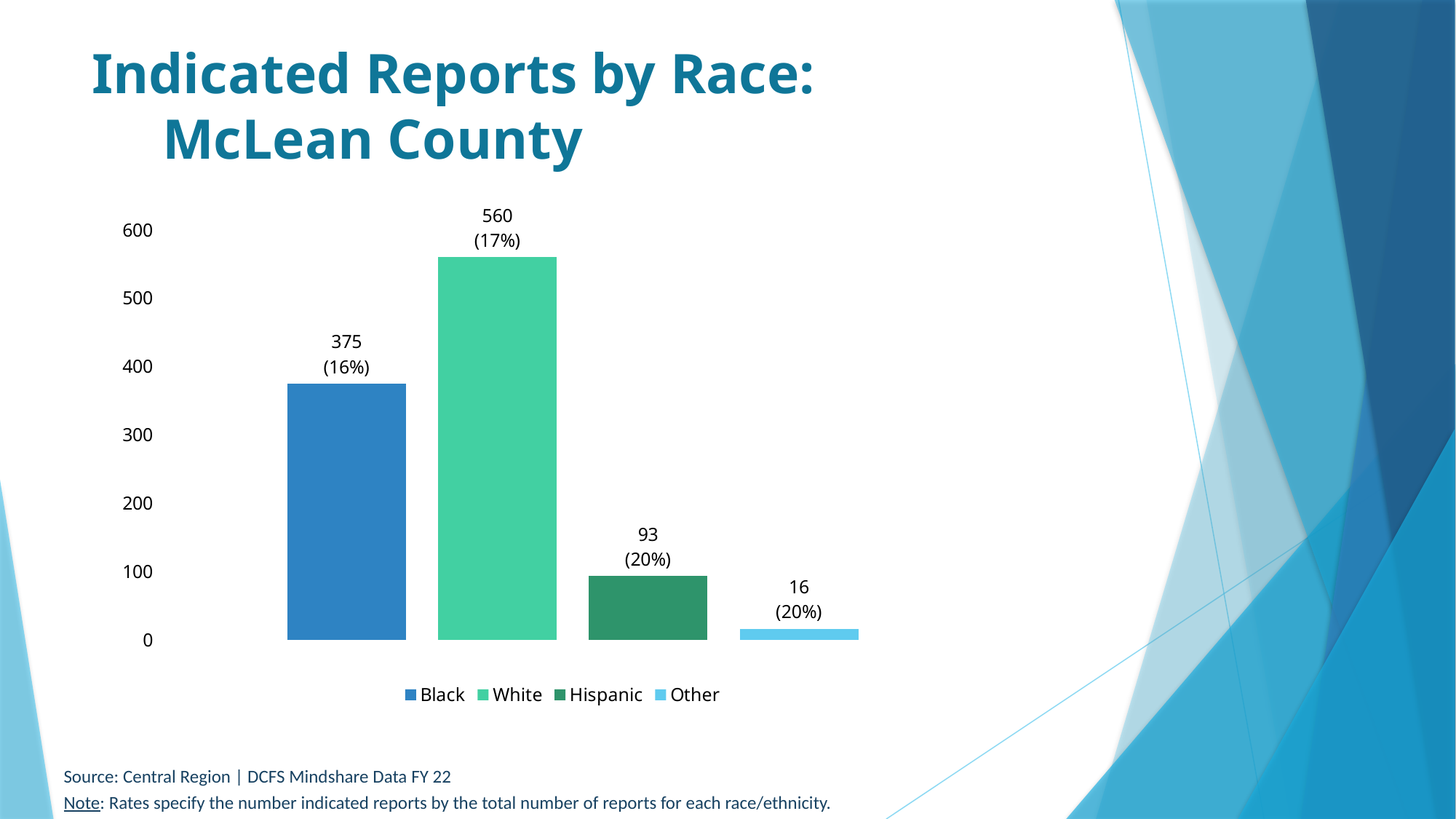
What is the title of the chart on the slide? Indicated Reports by Race: McLean County What kind of chart is shown on the slide? Bar chart What rate is shown in parentheses for Hispanic? 20% Which race/ethnicity has the highest number of indicated reports? White How many indicated reports are shown for Black? 375 What is the difference between the number of indicated reports for White and for Black? 185 Which race/ethnicity has the lowest number of indicated reports? Other Is the value for Black greater or less than 400? less How many race/ethnicity categories are plotted in the chart? 4 How many indicated reports are shown for Other? 16 Which has more indicated reports, Hispanic or Other? Hispanic How many indicated reports are shown for White? 560